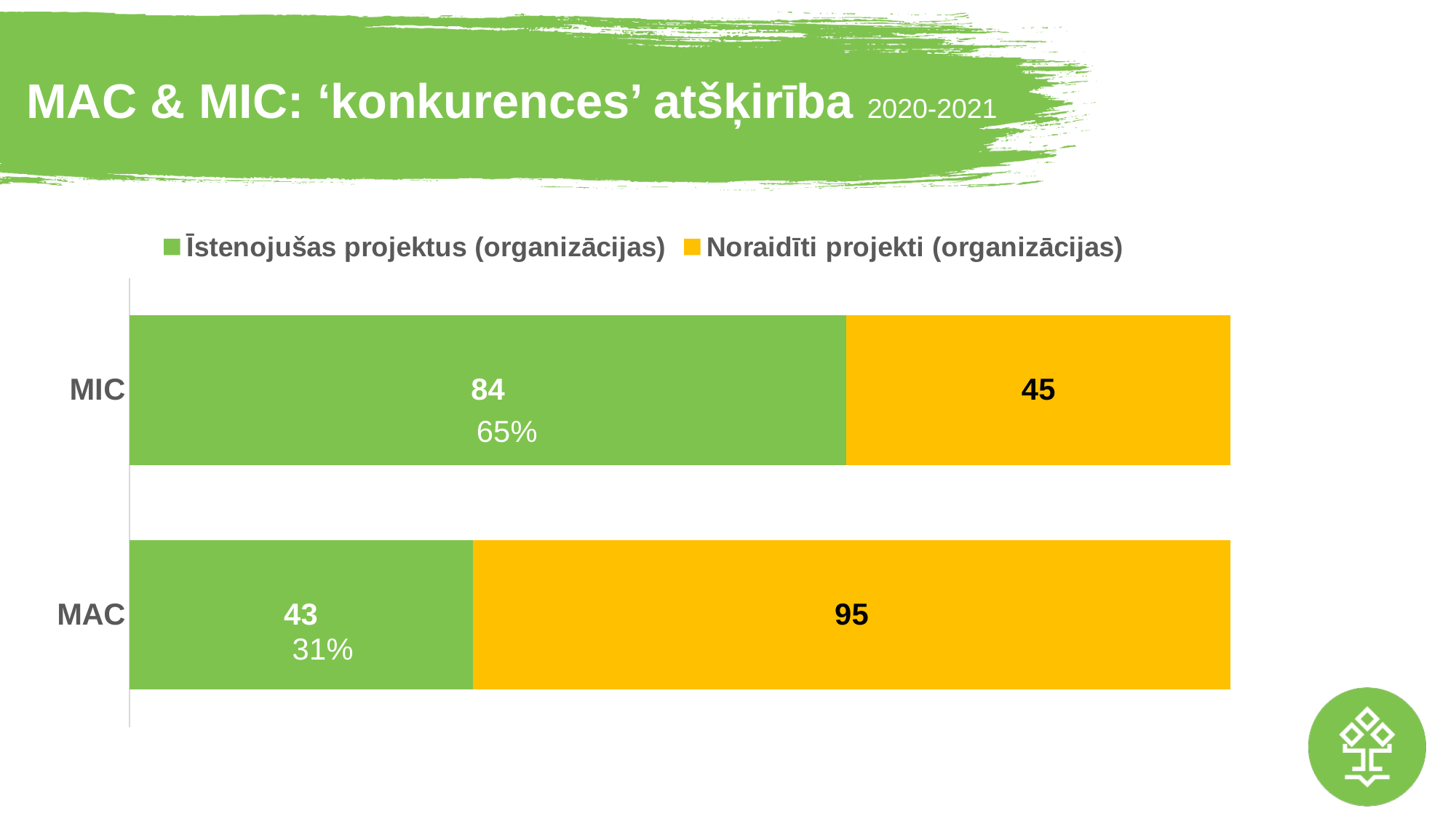
What percentage is shown on the green segment for MIC? 65% What is the value of Īstenojušas projektus (organizācijas) for MAC? 43 What kind of chart is shown on the slide? Stacked bar chart What is the difference between the Noraidīti projekti (organizācijas) values for MAC and MIC? 50 What is the value of Noraidīti projekti (organizācijas) for MIC? 45 What is the value of Noraidīti projekti (organizācijas) for MAC? 95 What is the total of the stacked bar for MAC? 138 What is the total of the stacked bar for MIC? 129 What is the value of Īstenojušas projektus (organizācijas) for MIC? 84 What percentage is shown on the green segment for MAC? 31% How many series does the legend list? 2 Which category has the higher Īstenojušas projektus (organizācijas) value, MIC or MAC? MIC